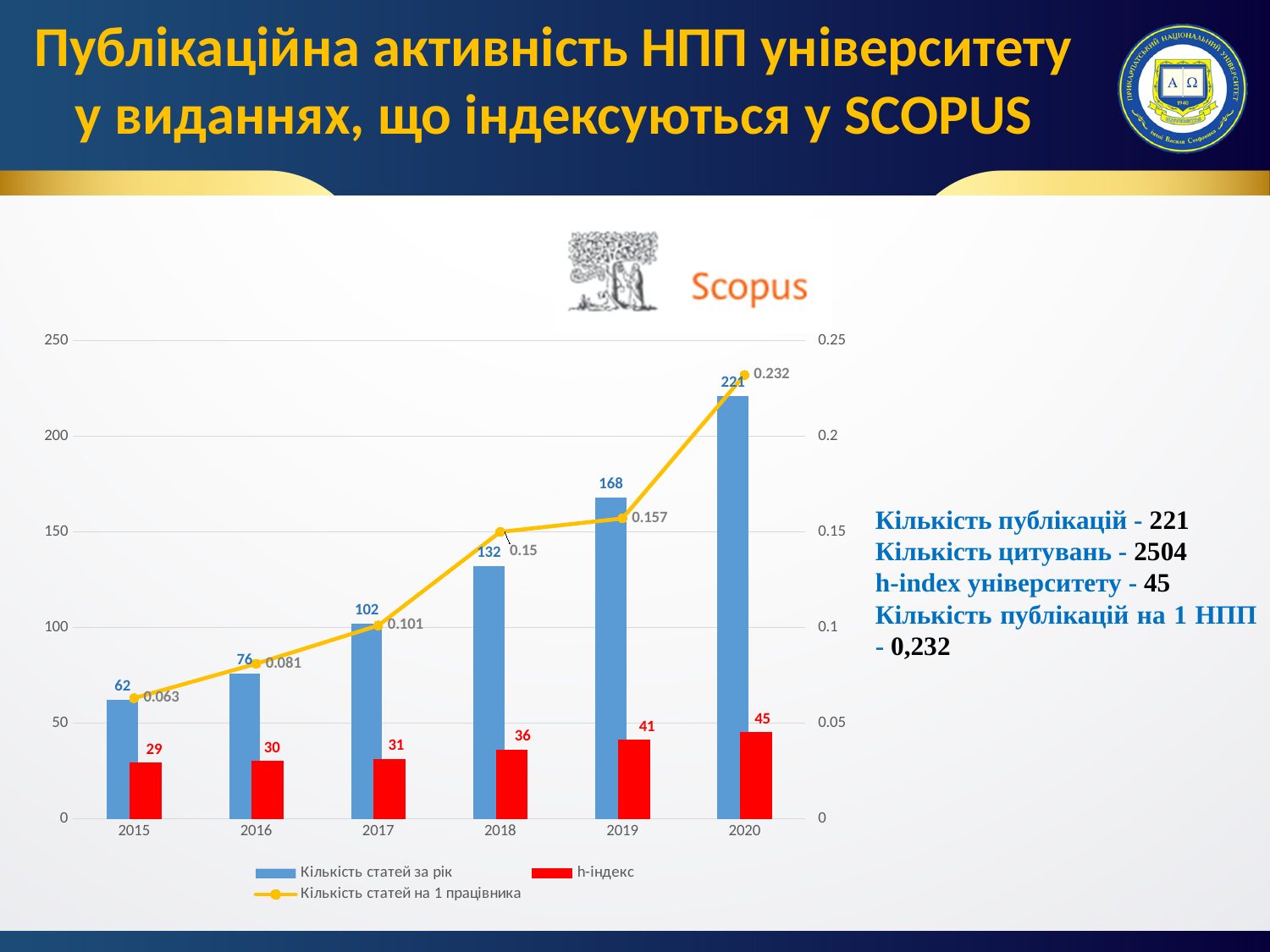
Which is larger: the h-індекс value for 2018 or for 2016? 2018 Is the value of "Кількість статей за рік" for 2019 greater or less than 150? greater What is the value of "Кількість статей за рік" for 2018? 132 What is the difference between the "Кількість статей за рік" values for 2020 and 2019? 53 What is the h-індекс value for 2019? 41 Which year has the highest value for "Кількість статей за рік"? 2020 How many years are shown on the x axis of the chart? 6 What is the value of "Кількість статей на 1 працівника" for 2017? 0.101 Does the "Кількість статей на 1 працівника" line rise or fall from 2015 to 2020? rise Which year has the lowest h-індекс value? 2015 What colour are the bars for the "h-індекс" series? red How many series does the chart legend list? 3